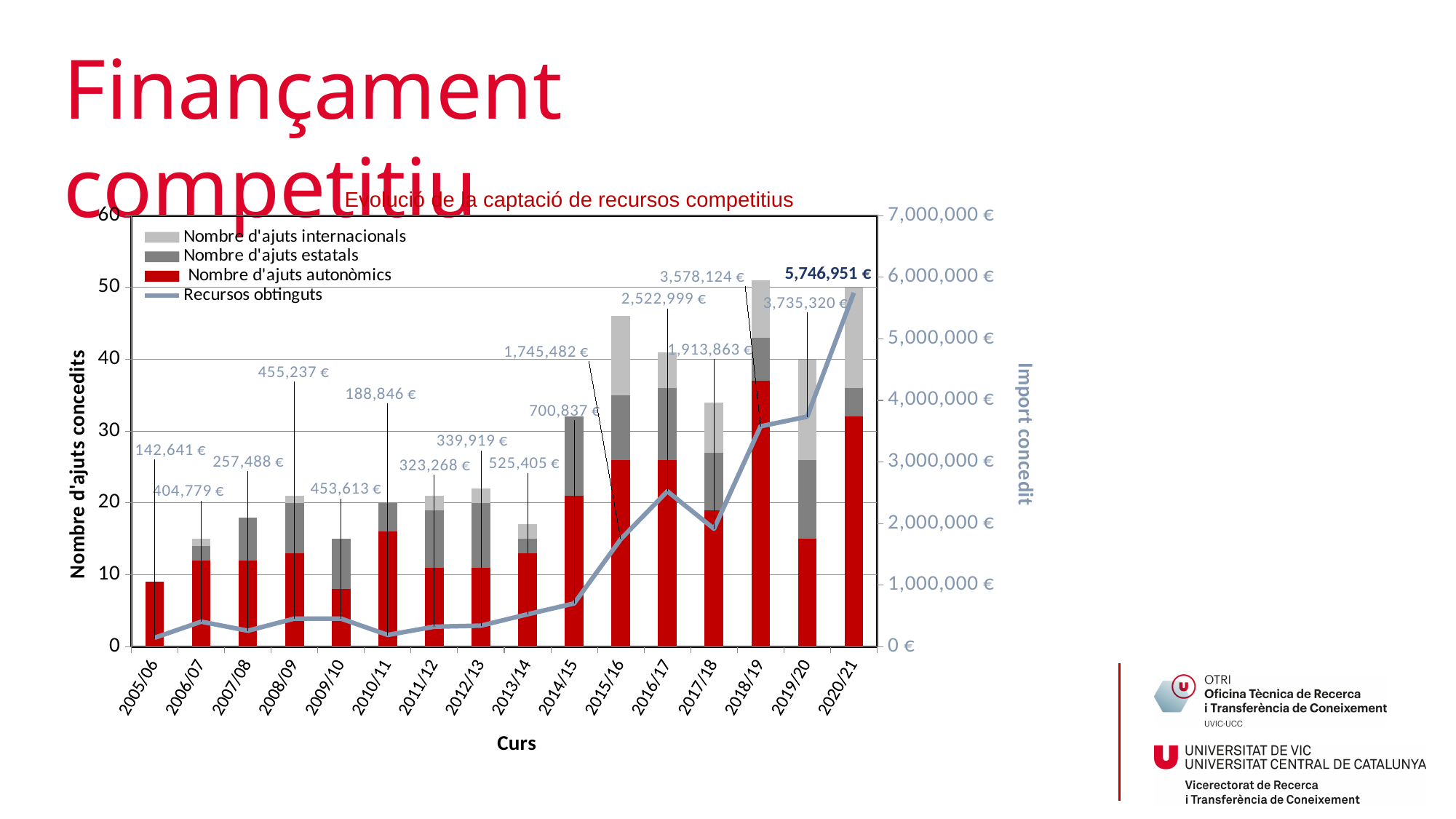
What kind of chart is shown on the slide? Stacked bar chart combined with a line chart What is the value of Recursos obtinguts for 2009/10? 453,613 € What is the value of Recursos obtinguts for 2015/16? 1,745,482 € How many academic years (Curs) are shown on the x axis? 16 What is the value of Recursos obtinguts for 2020/21? 5,746,951 € Which academic year (Curs) has the lowest Recursos obtinguts? 2005/06 Is the total number of ajuts concedits (full stacked bar) for 2018/19 greater or less than 40? greater How many series does the legend list? 4 What is the difference in Recursos obtinguts between 2020/21 and 2019/20? 2,011,631 € Which academic year (Curs) has the highest Recursos obtinguts? 2020/21 Is the number of ajuts autonòmics for 2005/06 greater or less than 10? less Which year has higher Recursos obtinguts, 2016/17 or 2017/18? 2016/17